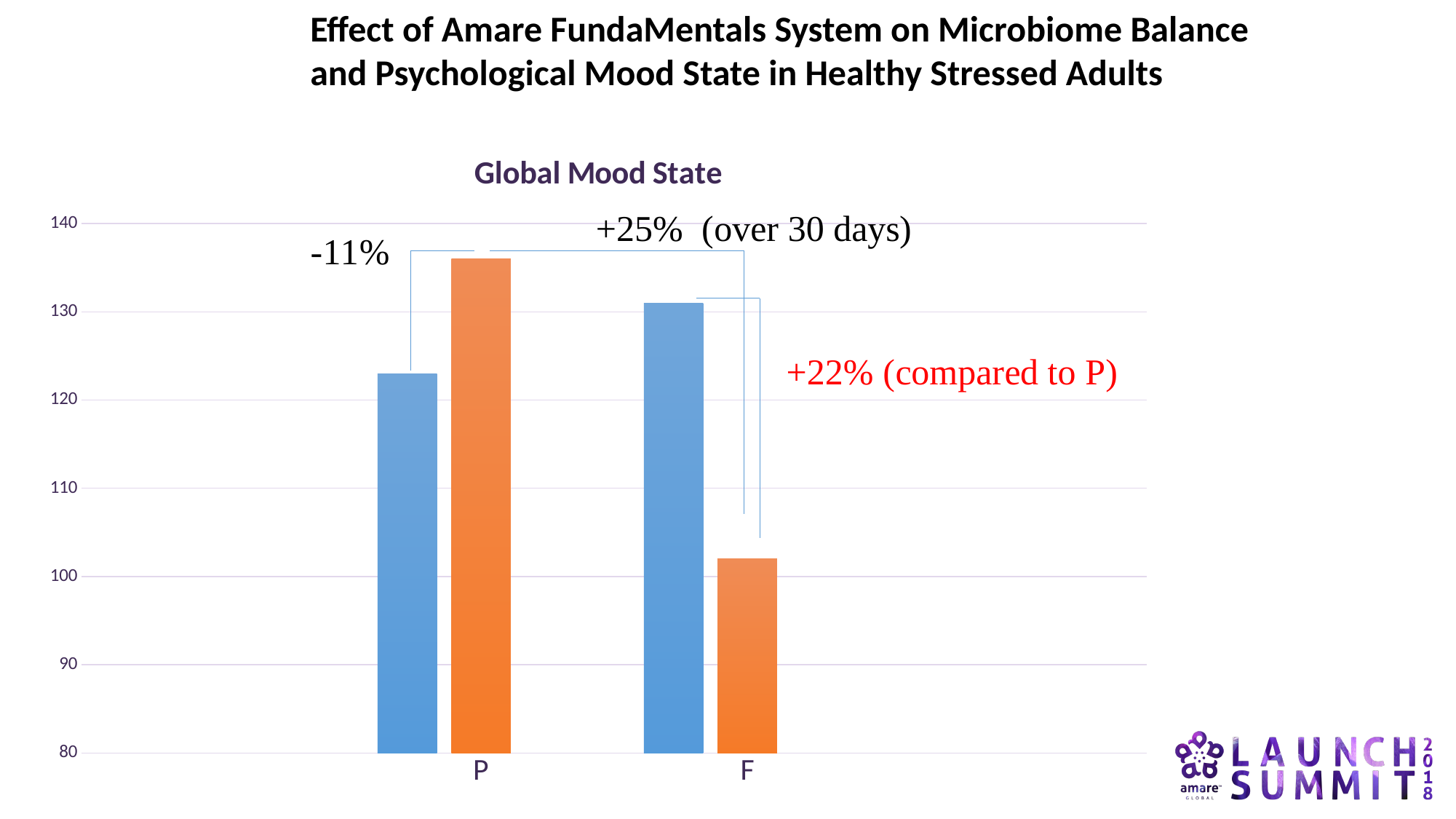
Is the value of the blue bar for F greater or less than 120? greater What are the two category labels on the x axis? P and F How many categories are shown on the x axis of the Global Mood State chart? 2 For category P, which bar is taller, the blue bar or the orange bar? the orange bar What is the title of the chart? Global Mood State For category F, which bar is taller, the blue bar or the orange bar? the blue bar What kind of chart is shown under the heading 'Global Mood State'? bar chart Is the value of the orange bar for P greater or less than 130? greater Which bar is the shortest in the chart? the orange bar for F Which bar is the tallest in the chart? the orange bar for P Is the value of the blue bar for P greater or less than 120? greater